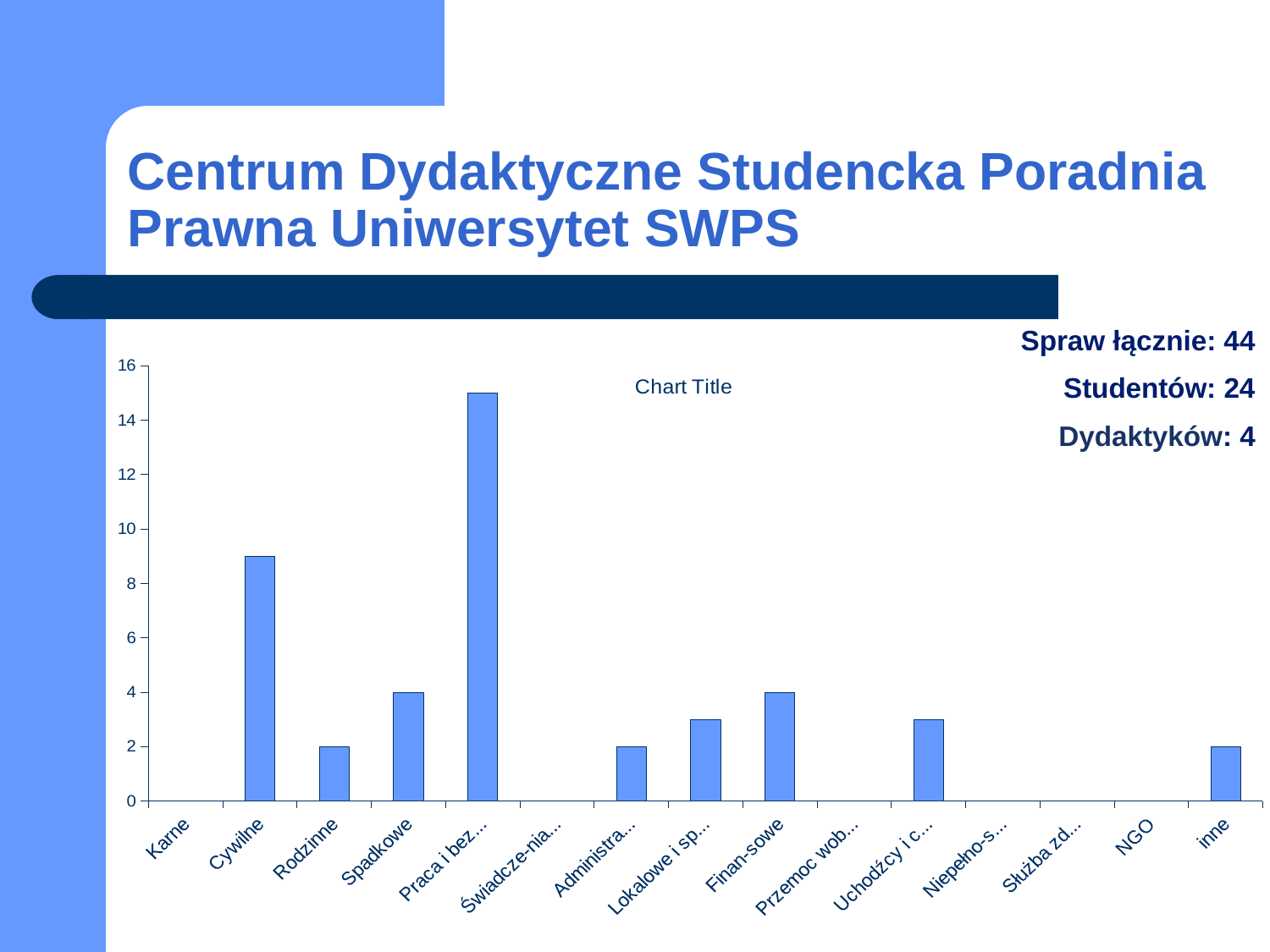
What is the value for Finan-sowe? 4 Is the value for Praca i bez... greater or less than 14? greater How many categories are shown on the x axis of the chart? 15 What is the value for Rodzinne? 2 Which category has the highest bar in the chart? Praca i bez... Is the value for Uchodźcy i c... greater or less than 2? greater Is the value for Cywilne greater or less than 8? greater What is the value for inne? 2 What kind of chart is shown on the slide? bar chart Which is larger, the value for Cywilne or the value for Spadkowe? Cywilne What is the value for Spadkowe? 4 What is the difference between the values for Spadkowe and Rodzinne? 2